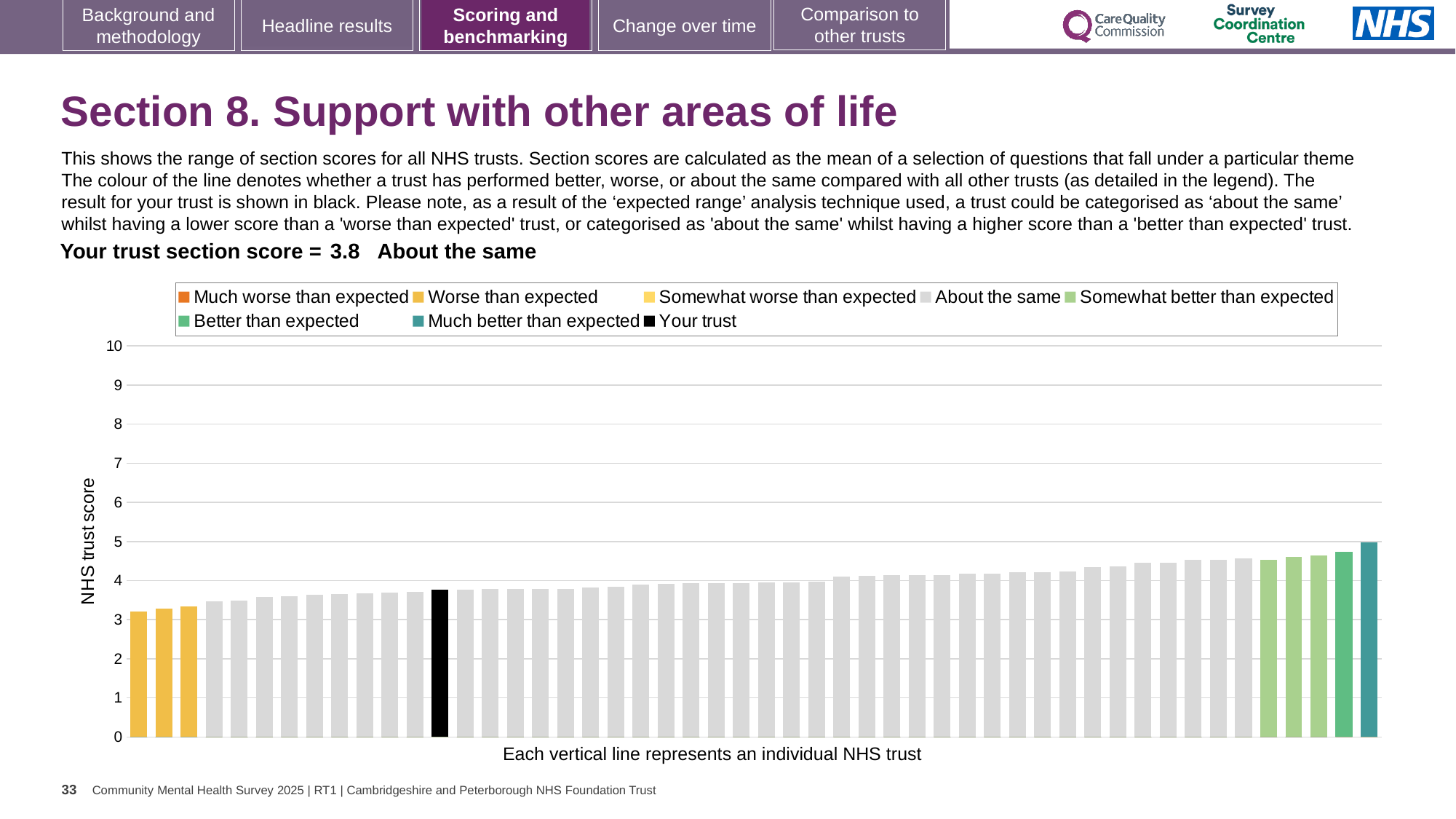
Which legend category does the highest bar belong to? Much better than expected Do the trust scores rise or fall from left to right along the x axis? rise What kind of chart is shown on the slide? bar chart Is the value for your trust greater or less than 4? less Which category is your trust's section score placed in? About the same How many entries does the chart legend list? 8 Is the value for the lowest-scoring trust (leftmost bar) greater or less than 3? greater How many bars are coloured as 'Worse than expected'? 3 What is your trust's section score for Section 8? 3.8 What is the label on the y axis of the chart? NHS trust score Which legend category do the lowest bars belong to? Worse than expected Is the value for the highest-scoring trust (rightmost bar) greater or less than 4? greater